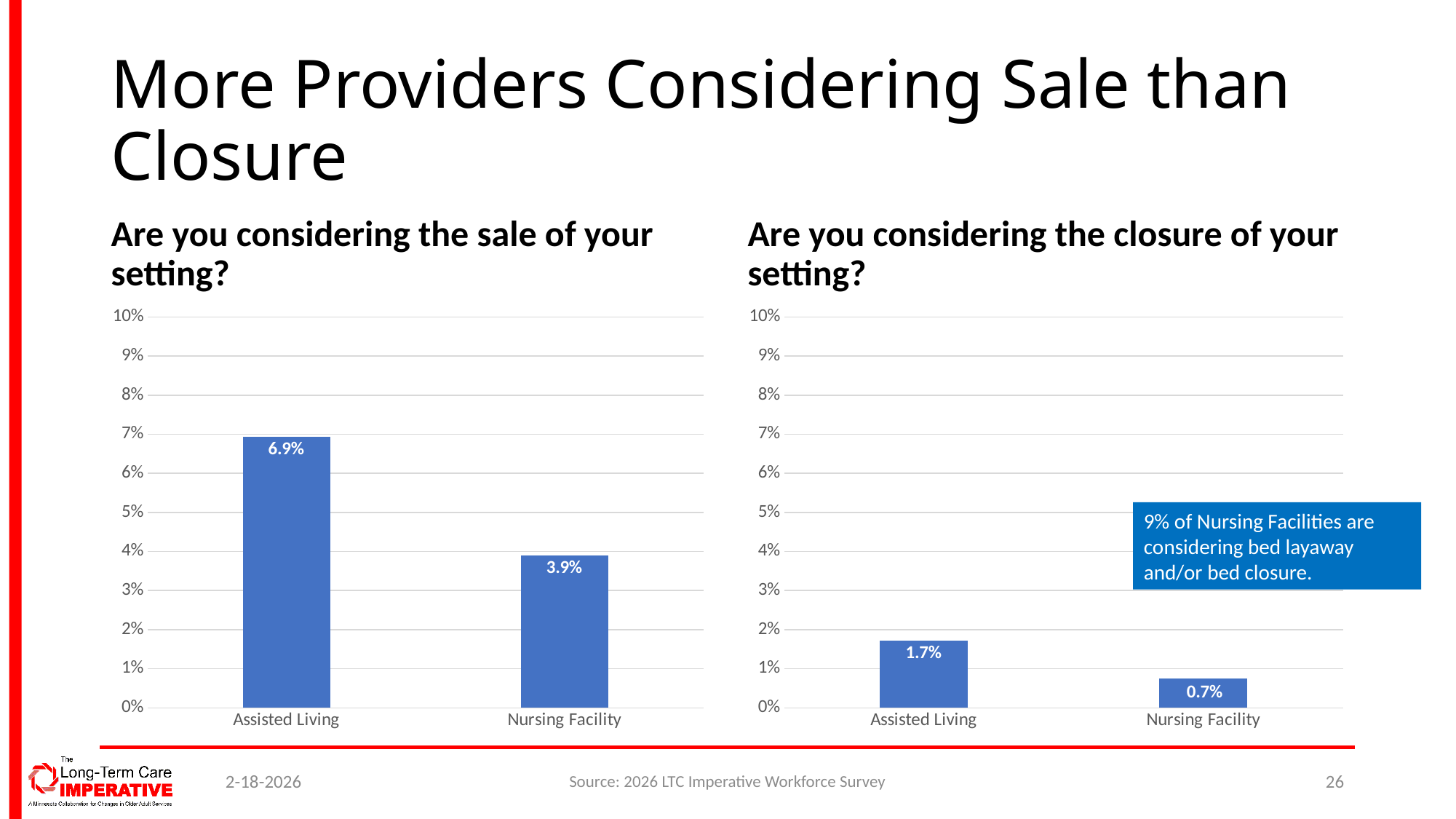
In the chart titled "Are you considering the closure of your setting?", what is the value for Nursing Facility? 0.7% In the chart titled "Are you considering the closure of your setting?", what is the value for Assisted Living? 1.7% In the chart titled "Are you considering the sale of your setting?", is the value for Nursing Facility greater or less than 5%? less In the chart titled "Are you considering the closure of your setting?", what is the difference between the Assisted Living and Nursing Facility values? 1.0% In the chart titled "Are you considering the sale of your setting?", what is the value for Assisted Living? 6.9% In the chart titled "Are you considering the sale of your setting?", what is the difference between the Assisted Living and Nursing Facility values? 3.0% In the chart titled "Are you considering the sale of your setting?", what is the value for Nursing Facility? 3.9% What kind of chart is the chart titled "Are you considering the sale of your setting?"? Bar chart In the chart titled "Are you considering the sale of your setting?", which category has the highest value? Assisted Living Is the Assisted Living value in the sale chart (left) larger or smaller than the Assisted Living value in the closure chart (right)? larger How many categories are shown in the chart titled "Are you considering the closure of your setting?"? 2 In the chart titled "Are you considering the closure of your setting?", which category has the lowest value? Nursing Facility